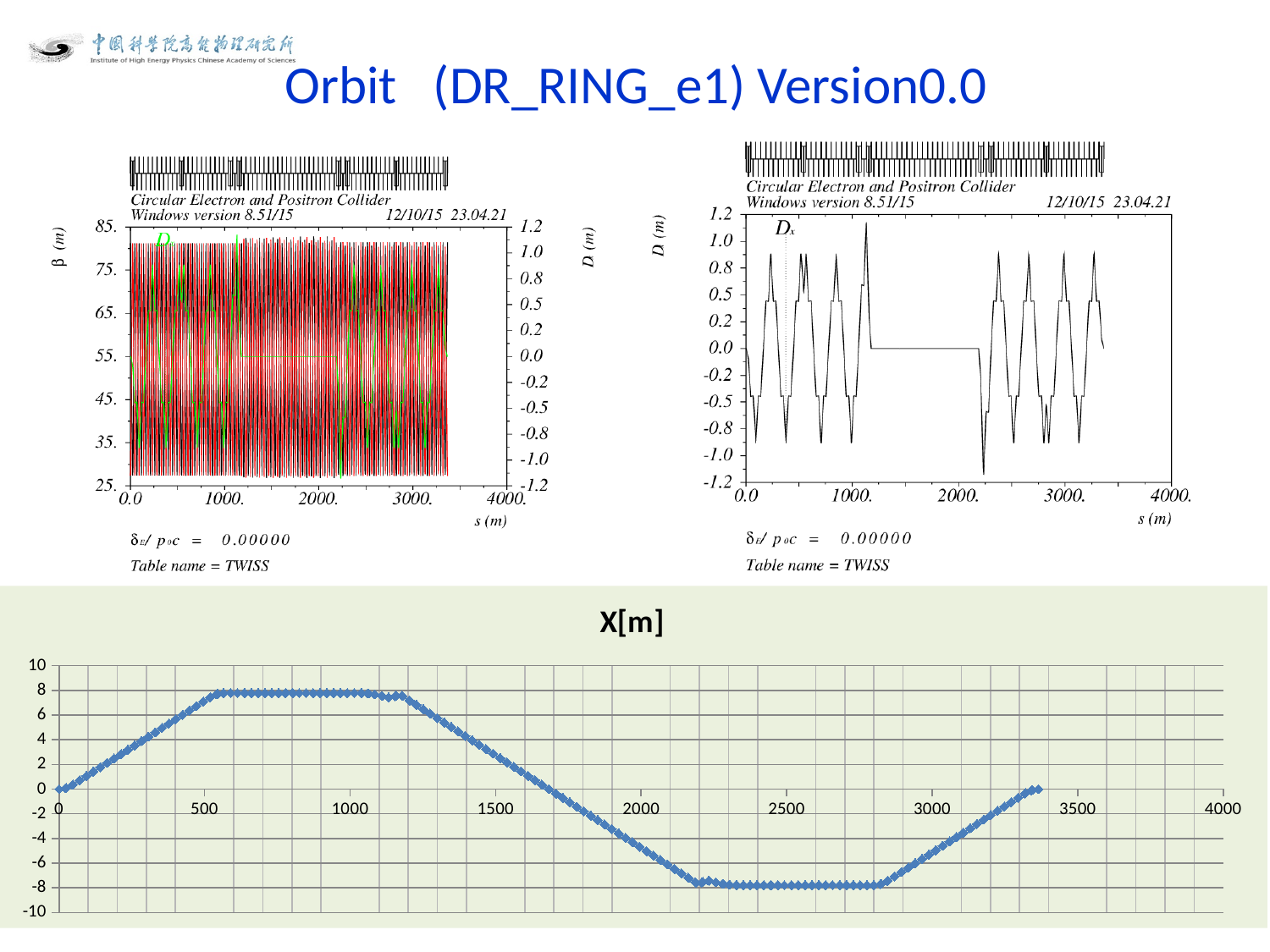
In the bottom chart X[m], is the value at x = 2500 greater or less than -6? less In the bottom chart X[m], is the value at x = 1500 greater or less than 0? greater In the bottom chart X[m], which is larger, the value at x = 1000 or the value at x = 2500? x = 1000 In the top right chart, what is the value of Dx at s = 1500? 0.0 What is the title of the bottom chart? X[m] In the bottom chart X[m], is the value at x = 800 greater or less than 6? greater What kind of chart is the bottom chart titled X[m]? scatter chart How many charts are shown on the slide? 3 In the bottom chart X[m], do the values rise or fall between x = 0 and x = 500? rise In the bottom chart X[m], do the values rise or fall between x = 1200 and x = 2200? fall In the bottom chart X[m], what is the value at x = 0? 0